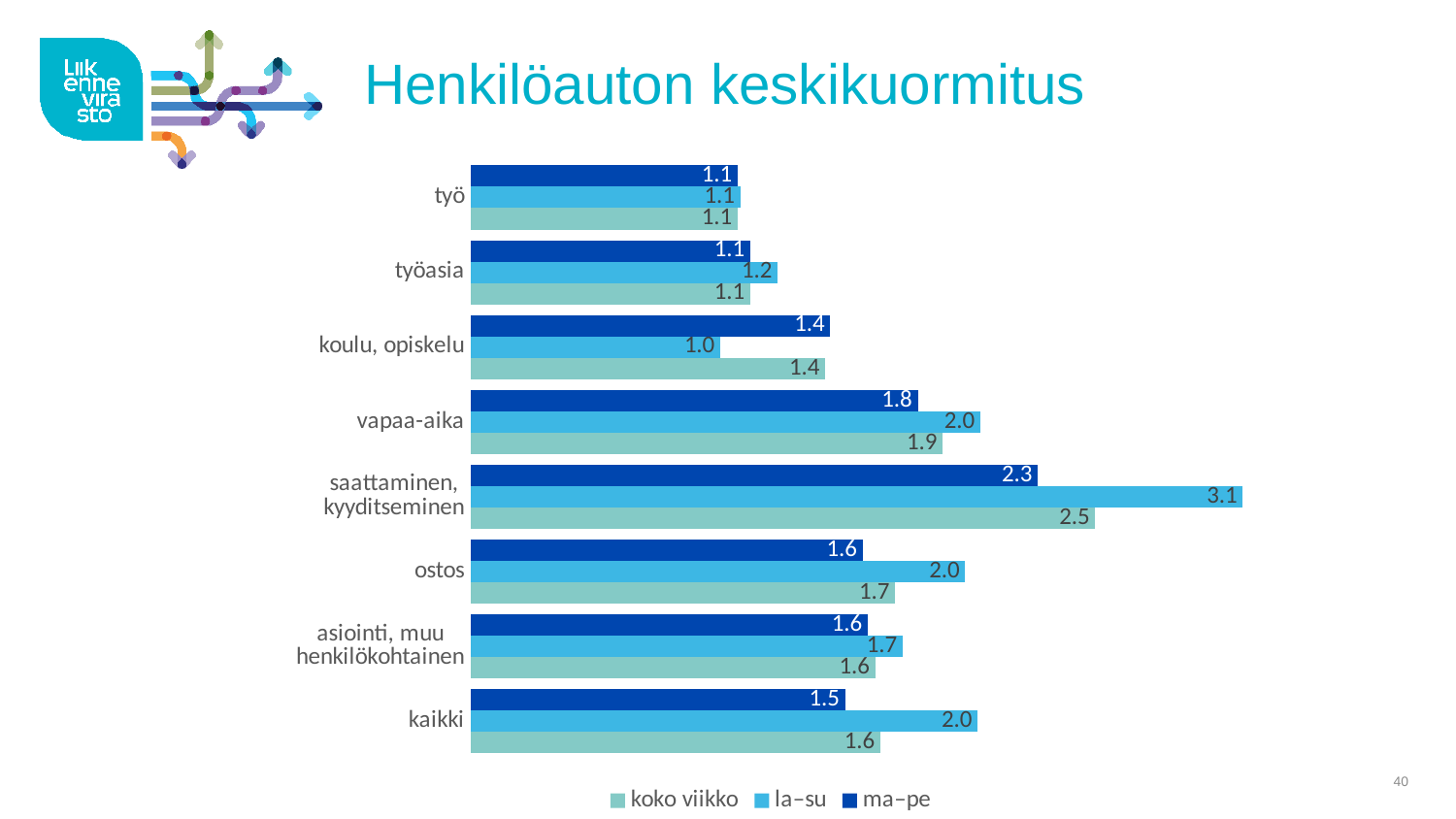
What is the la–su value for saattaminen, kyyditseminen? 3.1 How many categories are shown on the chart? 8 Which is larger for ostos, the la–su value or the ma–pe value? la–su How many series does the legend list? 3 What is the difference between the la–su and ma–pe values for saattaminen, kyyditseminen? 0.8 What is the la–su value for koulu, opiskelu? 1.0 What is the koko viikko value for kaikki? 1.6 What is the ma–pe value for vapaa-aika? 1.8 Which category has the lowest la–su value? koulu, opiskelu Which category has the highest la–su value? saattaminen, kyyditseminen What is the difference between the la–su and koko viikko values for kaikki? 0.4 What kind of chart is shown on the slide? bar chart